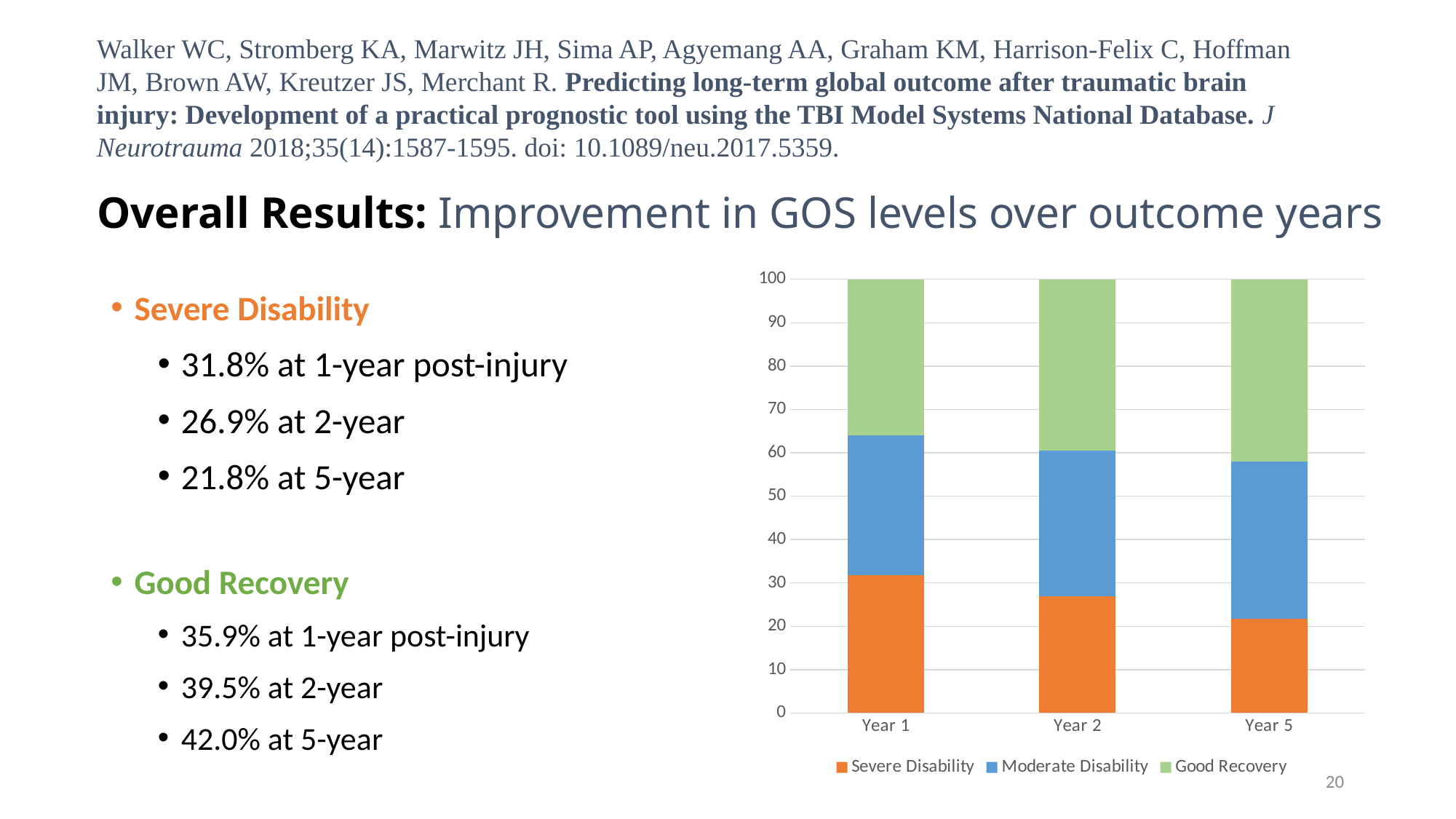
What kind of chart is shown on the slide? Stacked bar chart What are the three series listed in the chart legend? Severe Disability, Moderate Disability, Good Recovery According to the slide, by how much does Good Recovery at 5-year exceed Good Recovery at 1-year post-injury? 6.1% What is the total height of the stacked bar for Year 2? 100 Which is larger, the Severe Disability value for Year 1 or for Year 5? Year 1 Which colour represents Good Recovery in the chart? Green According to the slide, what is the Severe Disability percentage at 2-year? 26.9% How many outcome years (categories) are shown on the x axis of the chart? 3 Does the Severe Disability segment rise or fall from Year 1 to Year 5? Fall How many series does the chart legend list? 3 Is the Severe Disability value for Year 1 greater or less than 30? greater Is the Severe Disability value for Year 5 greater or less than 25? less